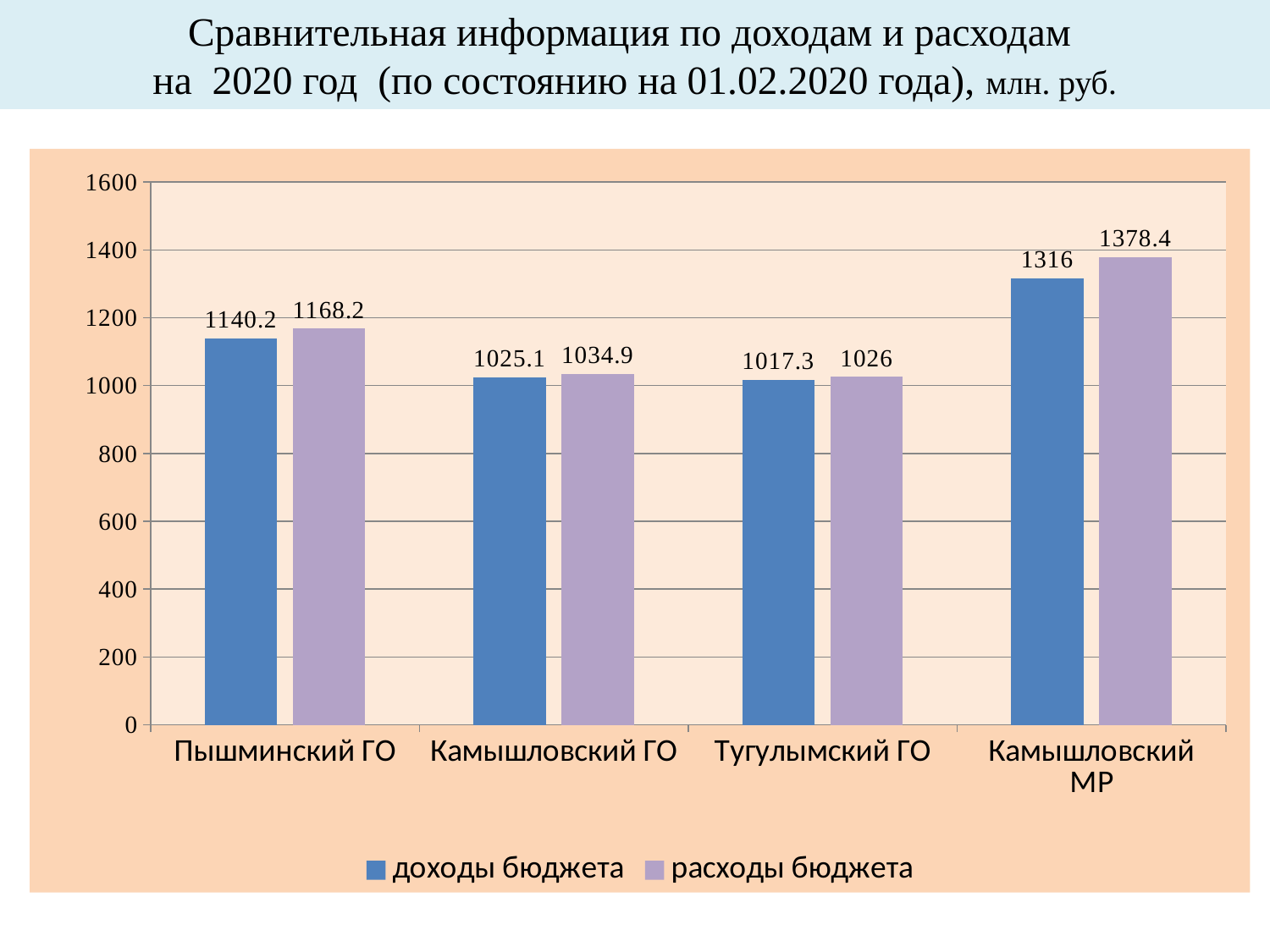
What kind of chart is shown on the slide? bar chart Which category has the highest доходы бюджета? Камышловский МР What is the value of расходы бюджета for Тугулымский ГО? 1026 How many categories are shown on the x axis? 4 What is the value of расходы бюджета for Камышловский МР? 1378.4 What colour are the bars for расходы бюджета? purple What is the value of доходы бюджета for Камышловский ГО? 1025.1 Which is larger for Пышминский ГО: доходы бюджета or расходы бюджета? расходы бюджета How many series does the legend list? 2 What is the difference between расходы бюджета and доходы бюджета for Камышловский МР? 62.4 What is the value of доходы бюджета for Пышминский ГО? 1140.2 Which category has the lowest расходы бюджета? Тугулымский ГО